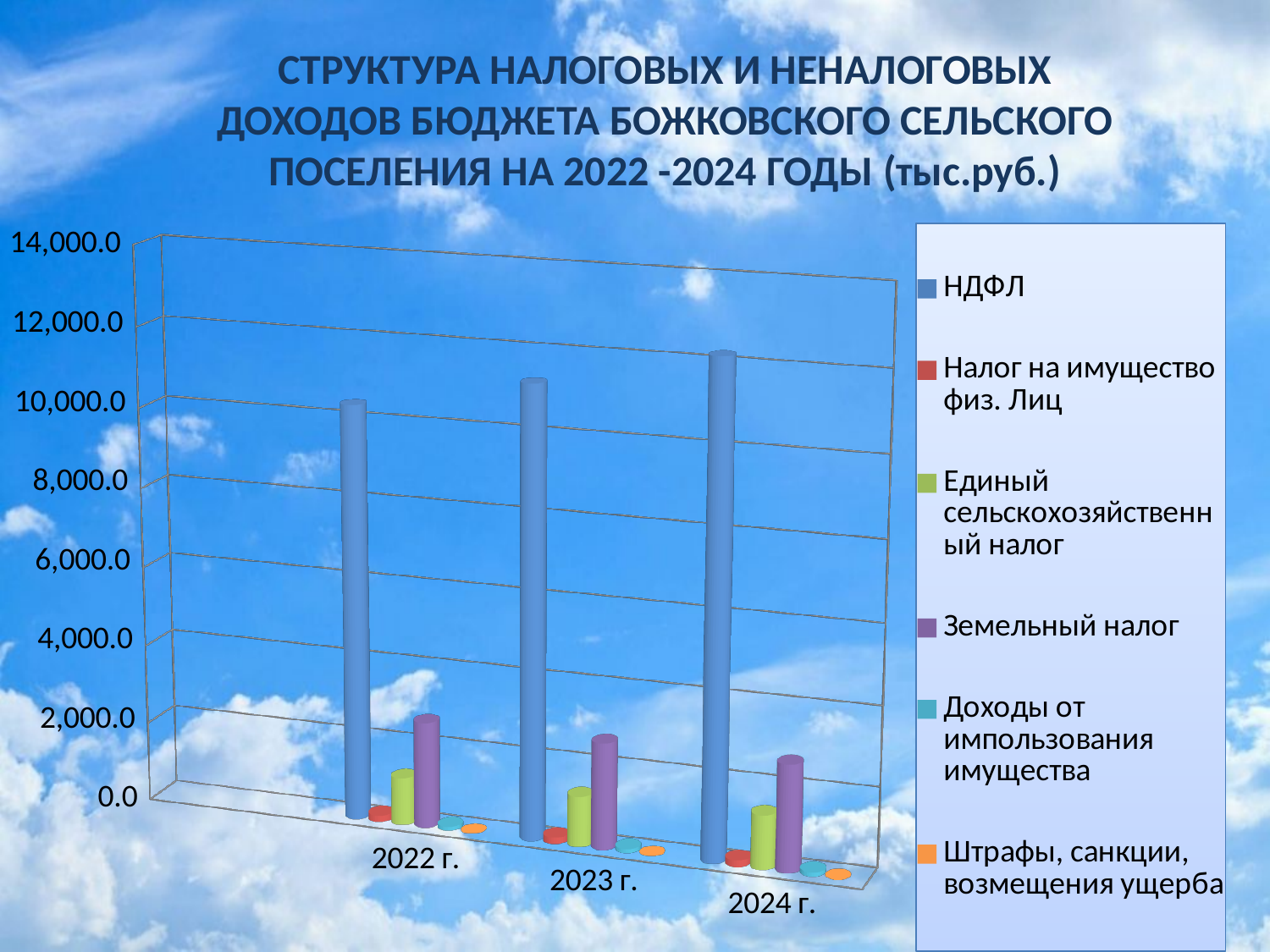
Is the value of НДФЛ for 2022 г. greater or less than 8,000.0? greater How many years (categories) are shown on the x axis of the chart? 3 Which colour represents НДФЛ in the chart's legend? blue Do the values of НДФЛ rise or fall from 2022 г. to 2024 г.? rise Which series has the highest value in 2022 г.? НДФЛ What kind of chart is shown on the slide? bar chart Which series has the highest value in 2024 г.? НДФЛ Is the value of Единый сельскохозяйственный налог for 2022 г. greater or less than 2,000.0? less How many series does the chart's legend list? 6